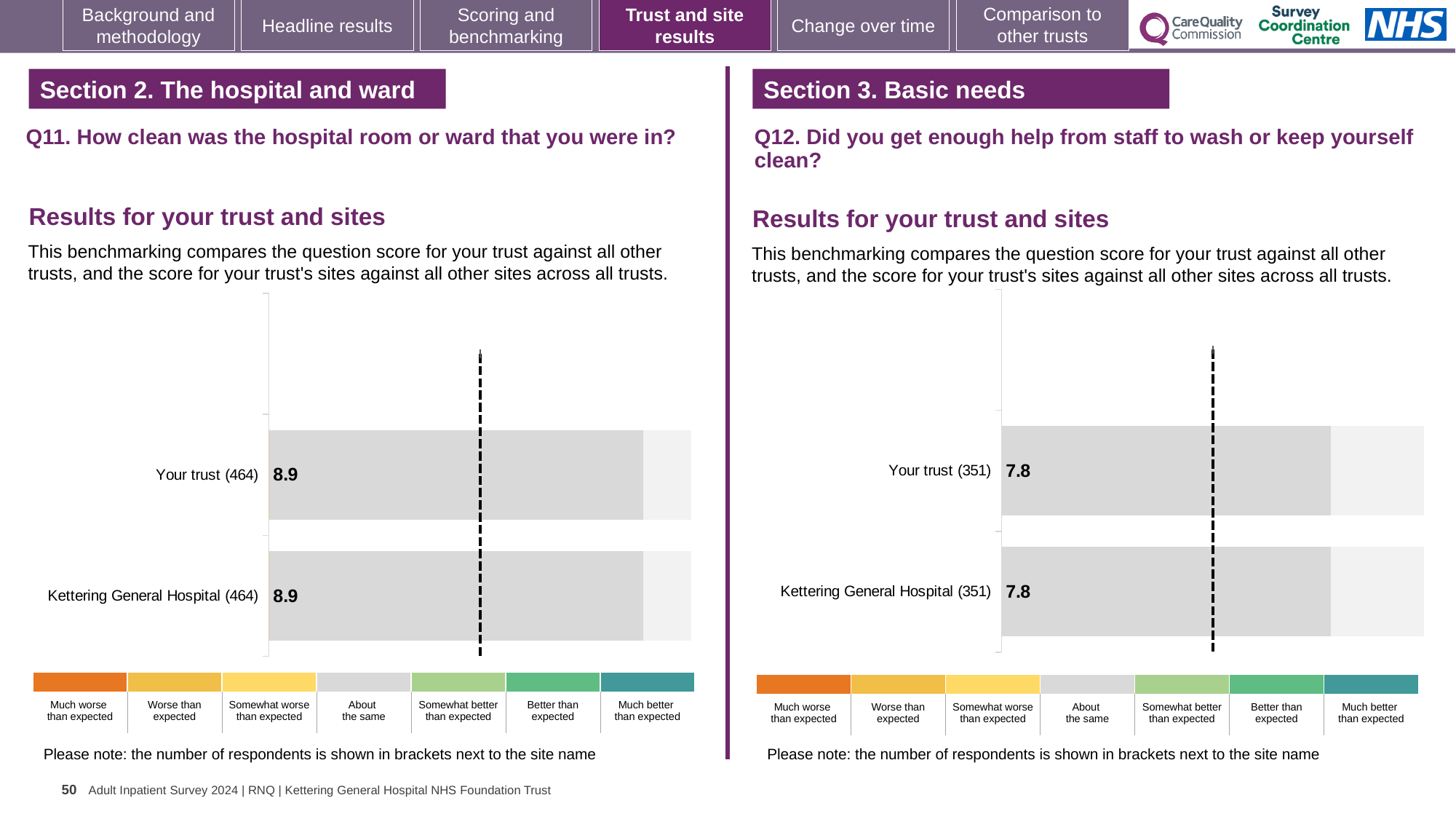
How many bars are plotted on the Q11 chart (left)? 2 On the Q11 chart (left), how many respondents are shown in brackets next to Your trust? 464 How many bars are plotted on the Q12 chart (right)? 2 What kind of chart is used for the Q11 results on the left? Bar chart On the Q11 chart (left), what is the difference between the score for Your trust and the score for Kettering General Hospital? 0 On the Q12 chart (right), what is the score for Kettering General Hospital? 7.8 On the Q12 chart (right), how many respondents are shown in brackets next to Kettering General Hospital? 351 On the Q12 chart (right), what is the difference between the score for Your trust and the score for Kettering General Hospital? 0 On the Q11 chart (left), what is the score for Your trust? 8.9 Is the score for Your trust on the Q11 chart (left) larger or smaller than the score for Your trust on the Q12 chart (right)? Larger On the Q12 chart (right), what is the score for Your trust? 7.8 On the Q11 chart (left), what is the score for Kettering General Hospital? 8.9